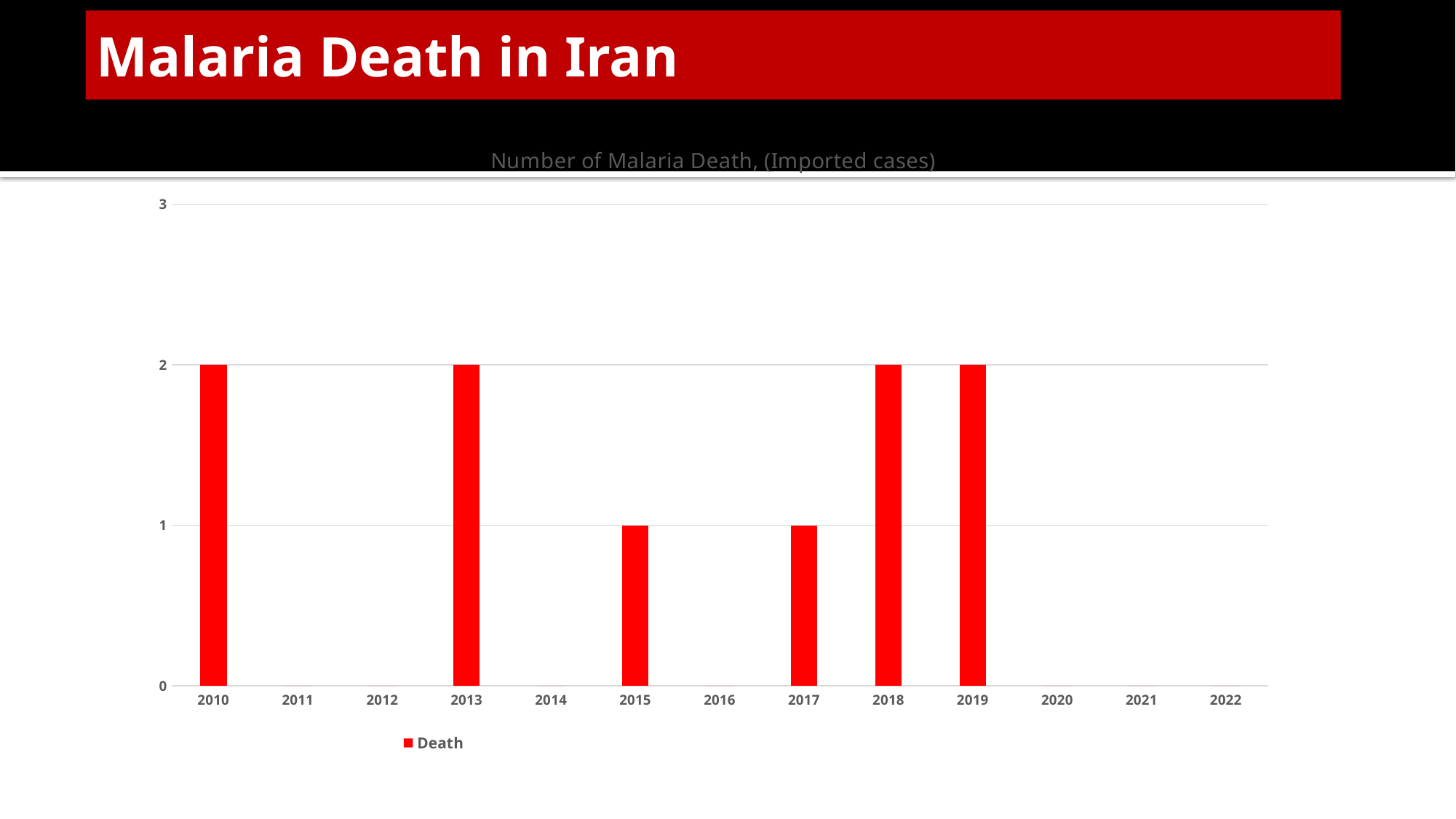
What is the number of deaths in 2010? 2 How many years are shown on the x axis? 13 What is the number of deaths in 2021? 0 What is the number of deaths in 2019? 2 What is the name of the series shown in the legend? Death How many series does the legend list? 1 Which is larger, the value for 2013 or the value for 2015? 2013 What kind of chart is shown on the slide? bar chart What is the number of deaths in 2015? 1 What is the difference between the value for 2018 and the value for 2017? 1 What is the title of the chart? Number of Malaria Death, (Imported cases) What is the number of deaths in 2017? 1